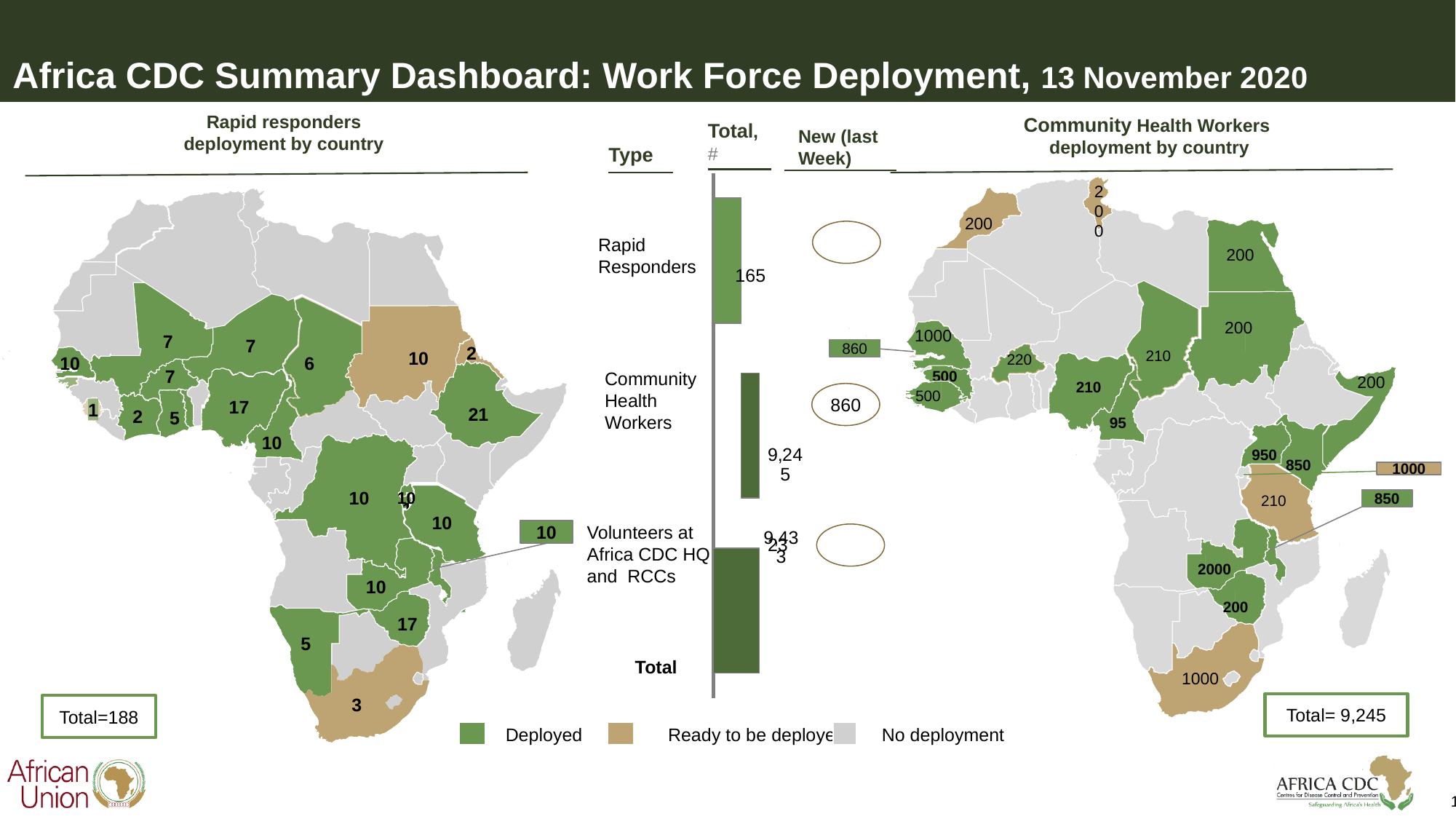
In the bar chart in the middle of the slide, what is the difference between the Total # for Community Health Workers and for Rapid Responders? 9,080 On the Rapid responders deployment by country map, what total is shown in the box at the bottom left? Total=188 On the Community Health Workers deployment by country map, what total is shown in the box at the bottom right? Total= 9,245 In the bar chart in the middle of the slide, what is the Total # for Rapid Responders? 165 What kind of chart is used in the middle of the slide to show the Total # by type? Bar chart In the bar chart in the middle of the slide, what is the Total # for Community Health Workers? 9,245 In the bar chart in the middle of the slide, which is larger: the Total # for Rapid Responders or for Community Health Workers? Community Health Workers According to the legend at the bottom of the slide, what does the green colour on the maps represent? Deployed In the bar chart in the middle of the slide, how many types are listed apart from the Total row? 3 In the bar chart in the middle of the slide, which type has the highest Total #? Community Health Workers In the bar chart in the middle of the slide, what is the New (last Week) value shown for Community Health Workers? 860 On the Rapid responders deployment by country map, what is the highest country value printed? 21